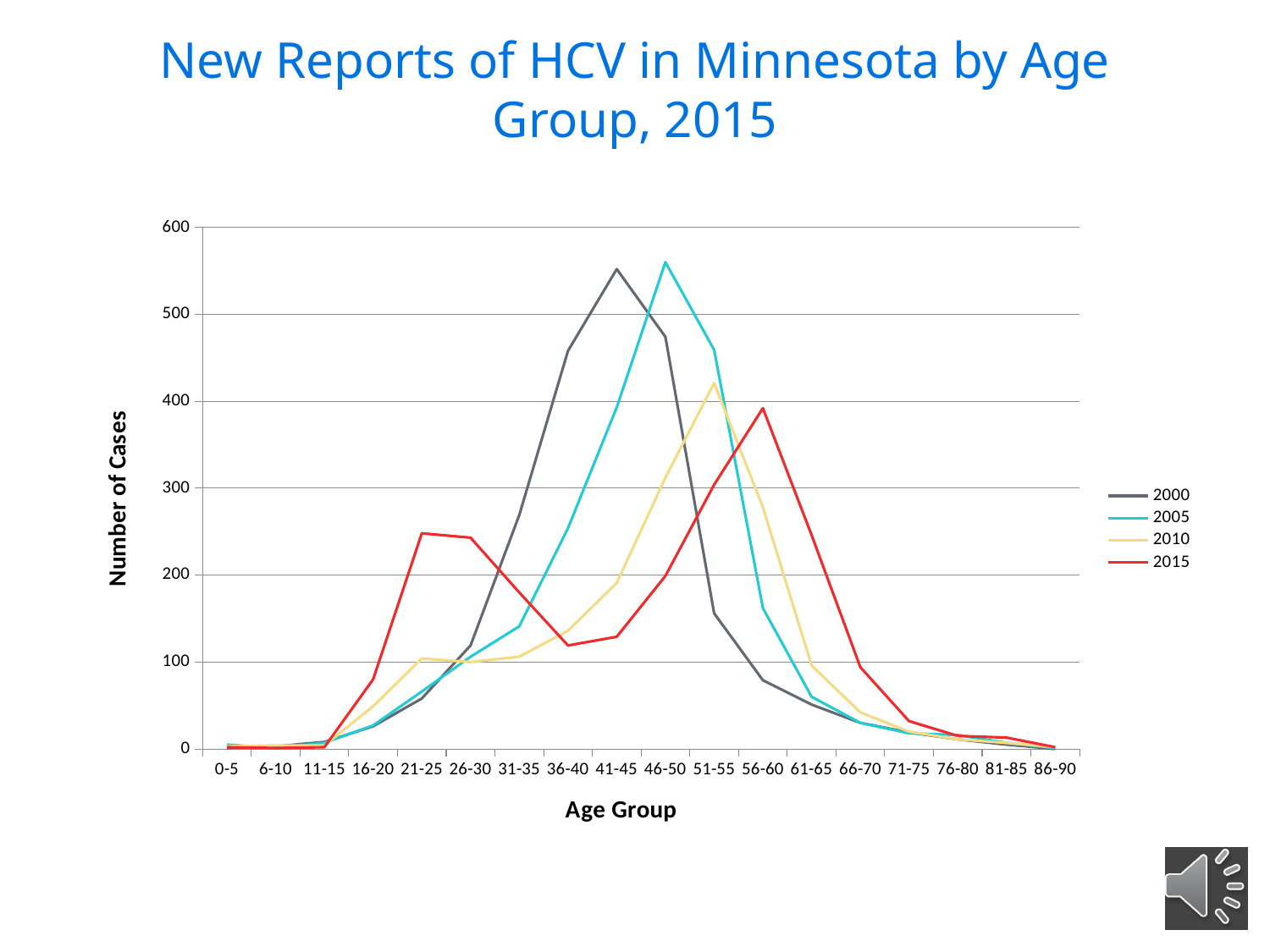
Which age group has the highest number of cases for the 2015 series? 56-60 For the 21-25 age group, which series has more cases, 2000 or 2015? 2015 Which colour is used for the 2015 series in the legend? red What kind of chart is shown on the slide? line chart How many series does the legend list? 4 Does the 2015 series rise or fall from the 56-60 age group to the 86-90 age group? fall How many age groups are shown on the x axis? 18 Is the 2005 value for the 56-60 age group greater or less than 200? less Which age group has the highest number of cases for the 2010 series? 51-55 Which age group has the highest number of cases for the 2000 series? 41-45 Is the 2000 value for the 41-45 age group greater or less than 500? greater Is the 2015 value for the 21-25 age group greater or less than 200? greater